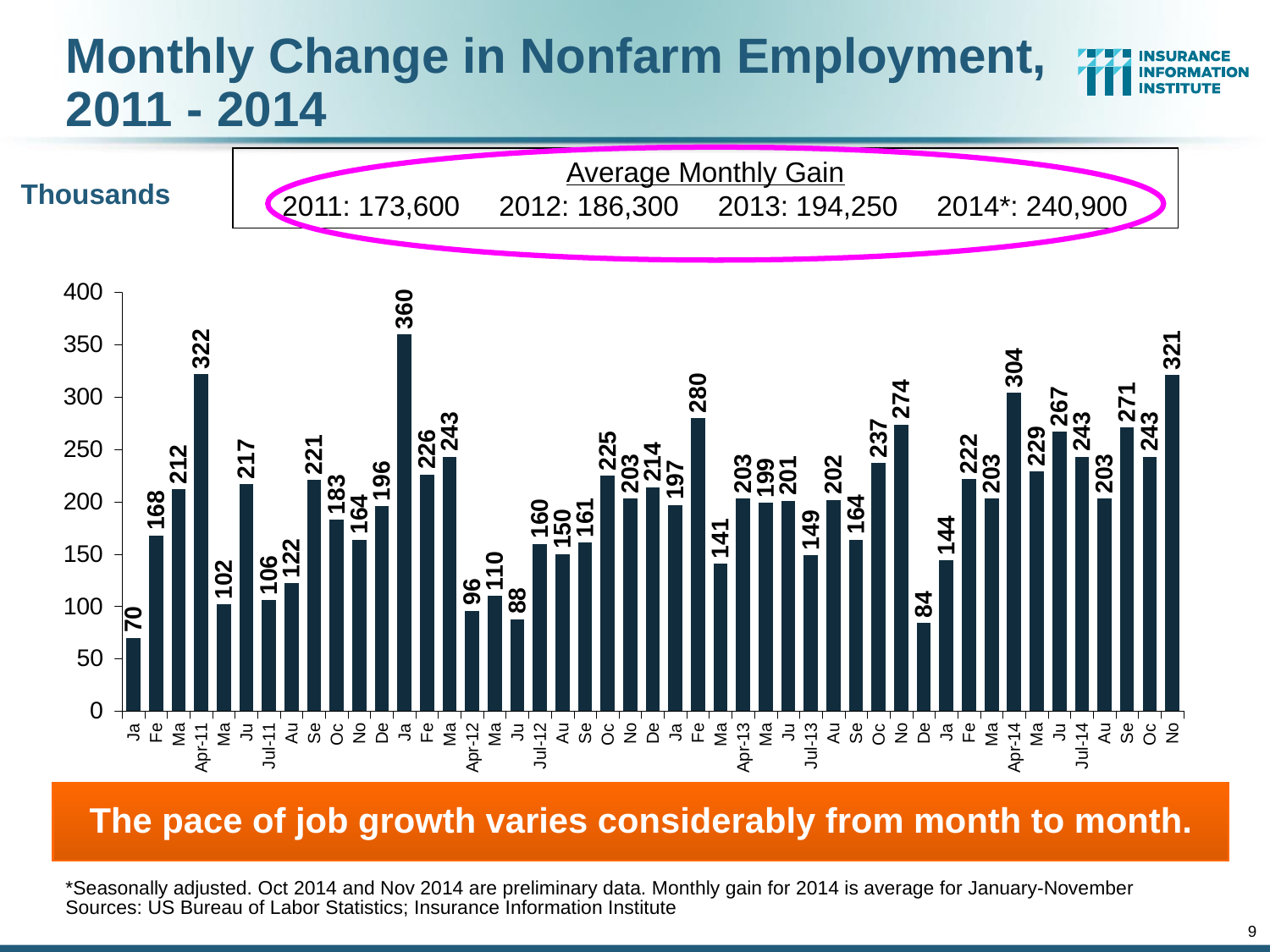
What is the value of the tallest bar in the chart? 360 What is the value of the shortest bar in the chart? 70 What unit label is shown for the vertical axis of the chart? Thousands What is the value of the rightmost bar (No, the last month shown)? 321 According to the box above the chart, what was the average monthly gain in 2014*? 240,900 What is the value for Apr-14? 304 Which is larger, the value for Jul-11 or the value for Jul-13? Jul-13 What kind of chart is shown on the slide? Bar chart What is the value for Jul-12? 160 What is the value for Apr-11? 322 How many bars are plotted in the chart? 47 How much larger is the value for Apr-14 than the value for Apr-13? 101